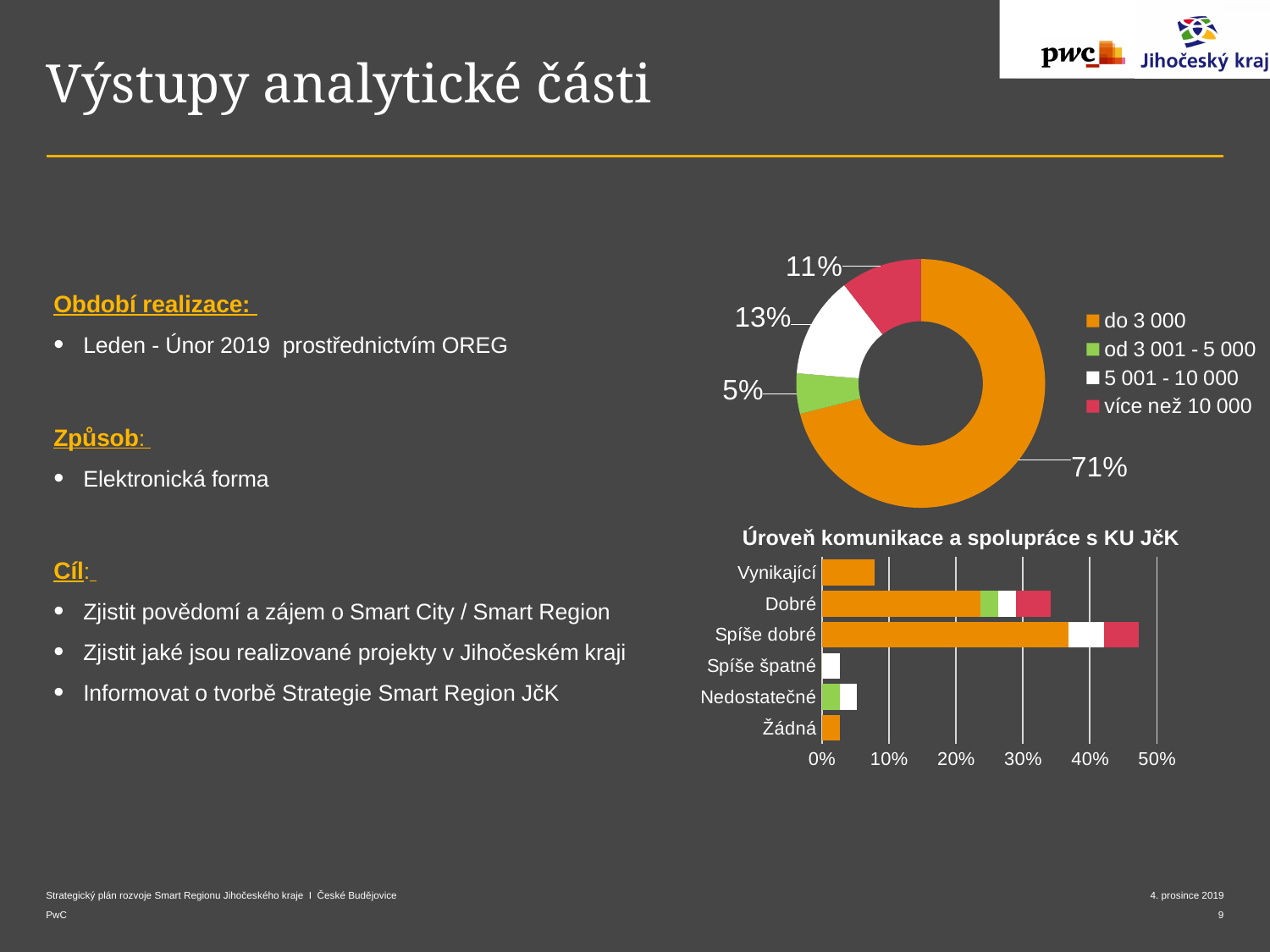
In the chart titled 'Úroveň komunikace a spolupráce s KU JčK', is the total bar for 'Spíše dobré' greater or less than 40%? greater In the chart titled 'Úroveň komunikace a spolupráce s KU JčK', which category has the longest bar? Spíše dobré In the donut chart at the top right, how many categories does the legend list? 4 In the donut chart at the top right, which category has the largest share? do 3 000 In the chart titled 'Úroveň komunikace a spolupráce s KU JčK', how many categories are shown on the vertical axis? 6 In the donut chart at the top right, what share is shown for the '5 001 - 10 000' category? 13% In the chart titled 'Úroveň komunikace a spolupráce s KU JčK', is the bar for 'Vynikající' greater or less than 10%? less In the donut chart at the top right, which category has the smallest share? od 3 001 - 5 000 What kind of chart is the chart at the top right of the slide? Donut (pie) chart In the donut chart at the top right, what is the difference between the shares for 'do 3 000' and '5 001 - 10 000'? 58% In the donut chart at the top right, what share is shown for the 'více než 10 000' category? 11% In the donut chart at the top right, what share is shown for the 'do 3 000' category? 71%